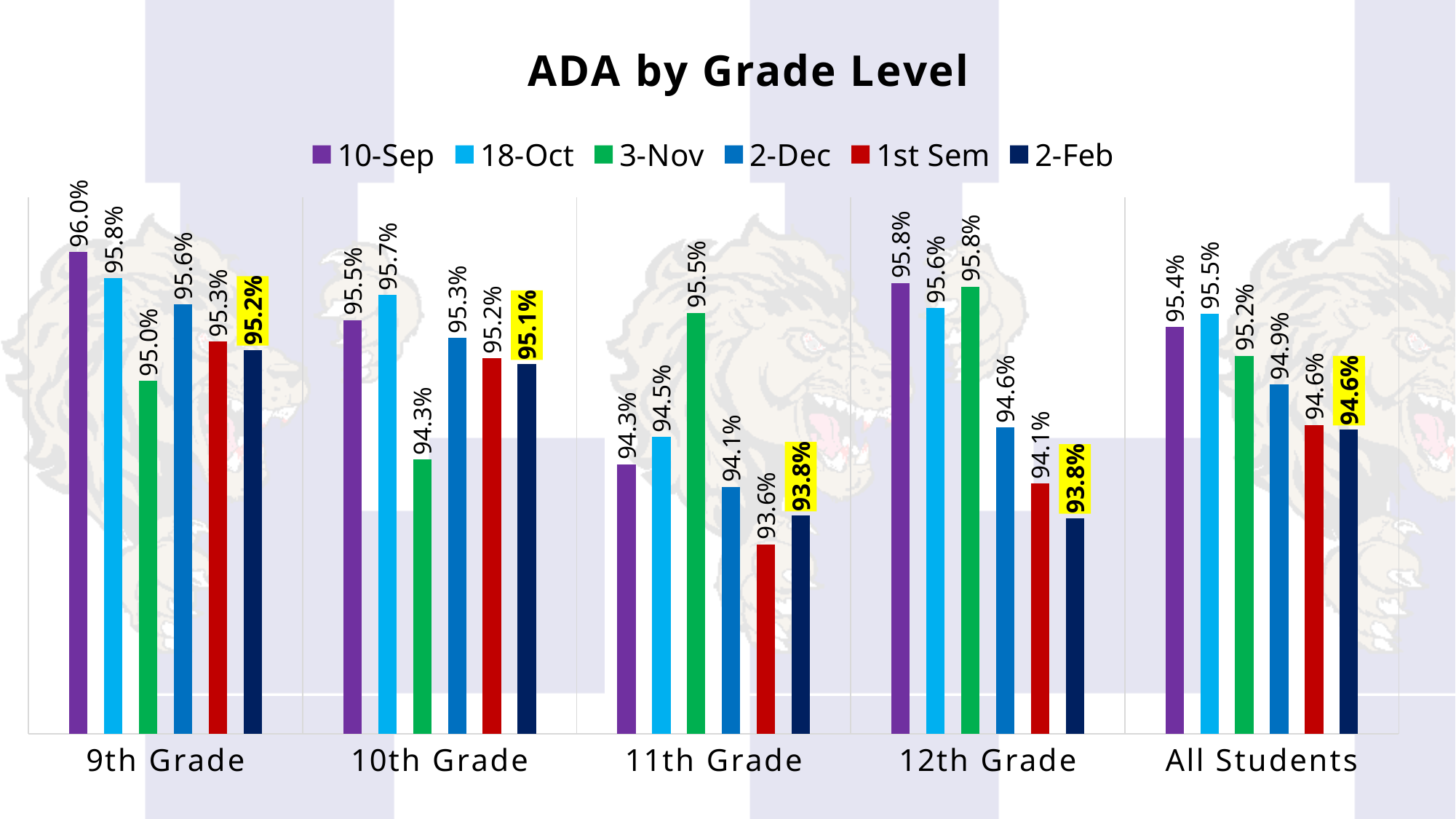
What kind of chart is shown on the slide? Bar chart What is the ADA for All Students on 2-Feb? 94.6% What is the title of the chart? ADA by Grade Level Which is larger: the 12th Grade ADA on 3-Nov or the 12th Grade ADA on 2-Dec? 3-Nov What is the ADA for 9th Grade on 10-Sep? 96.0% What is the ADA for 10th Grade on 3-Nov? 94.3% How many grade-level categories are shown on the x axis? 5 Which grade level has the lowest ADA on 2-Feb? 11th Grade and 12th Grade (tied at 93.8%) What is the ADA for 11th Grade for 1st Sem? 93.6% What is the difference between the 9th Grade and 11th Grade ADA on 2-Feb? 1.4% Which grade level has the highest ADA on 10-Sep? 9th Grade How many series does the legend list? 6